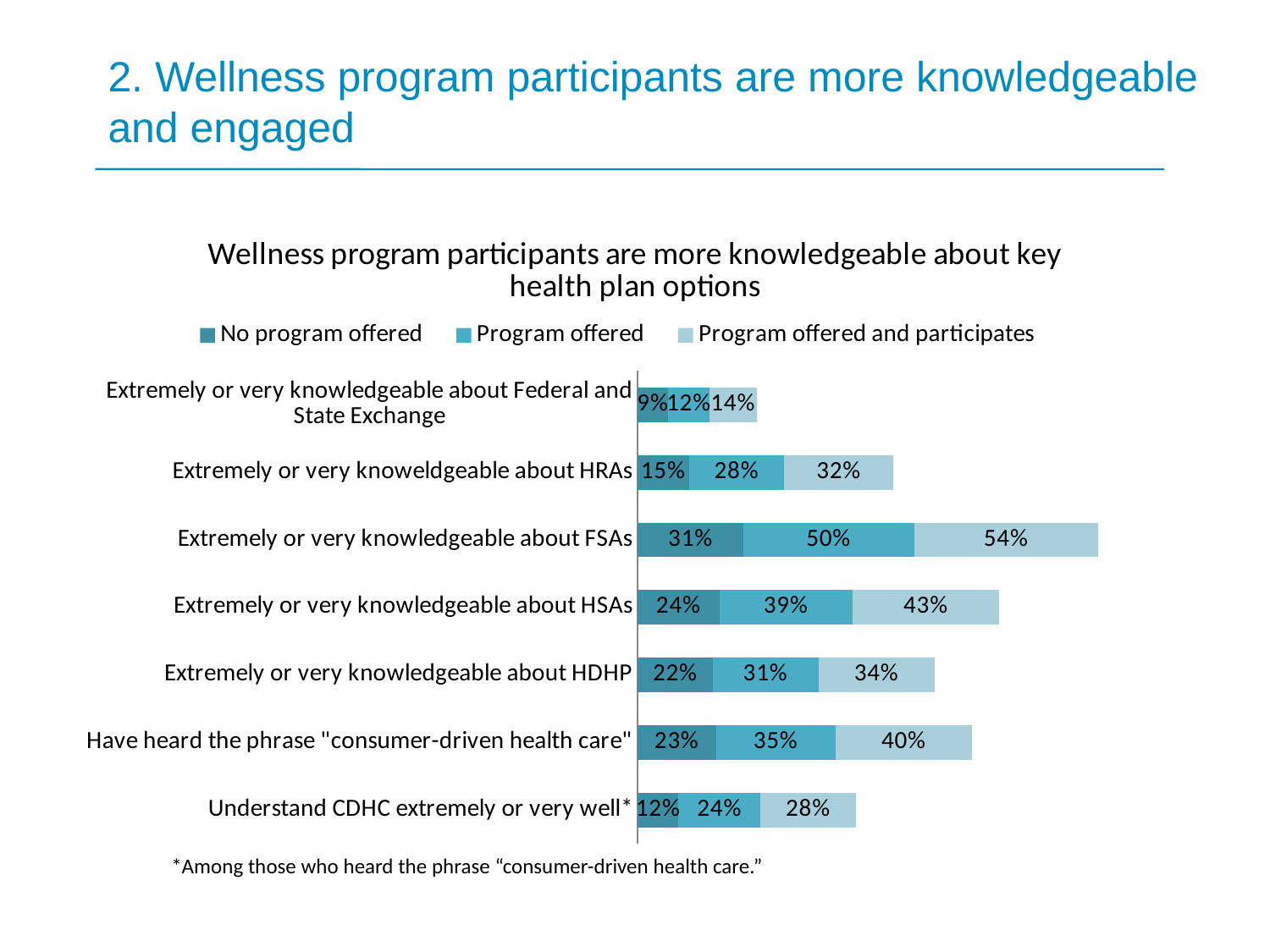
Which is larger for "Extremely or very knoweldgeable about HRAs": the "Program offered" value or the "Program offered and participates" value? Program offered and participates What is the value for "No program offered" for "Extremely or very knowledgeable about HSAs"? 24% What is the title of the chart? Wellness program participants are more knowledgeable about key health plan options How many categories are plotted on the chart? 7 What is the value for "Program offered and participates" for "Extremely or very knowledgeable about FSAs"? 54% What is the difference between the "Program offered and participates" and "No program offered" values for "Extremely or very knowledgeable about HDHP"? 12% What kind of chart is shown on the slide? Stacked bar chart How many series does the legend list? 3 Which category has the lowest value for "No program offered"? Extremely or very knowledgeable about Federal and State Exchange Which category has the highest value for "Program offered and participates"? Extremely or very knowledgeable about FSAs What is the value for "Program offered" for "Have heard the phrase "consumer-driven health care""? 35% What is the total of the stacked bar for "Understand CDHC extremely or very well*"? 64%